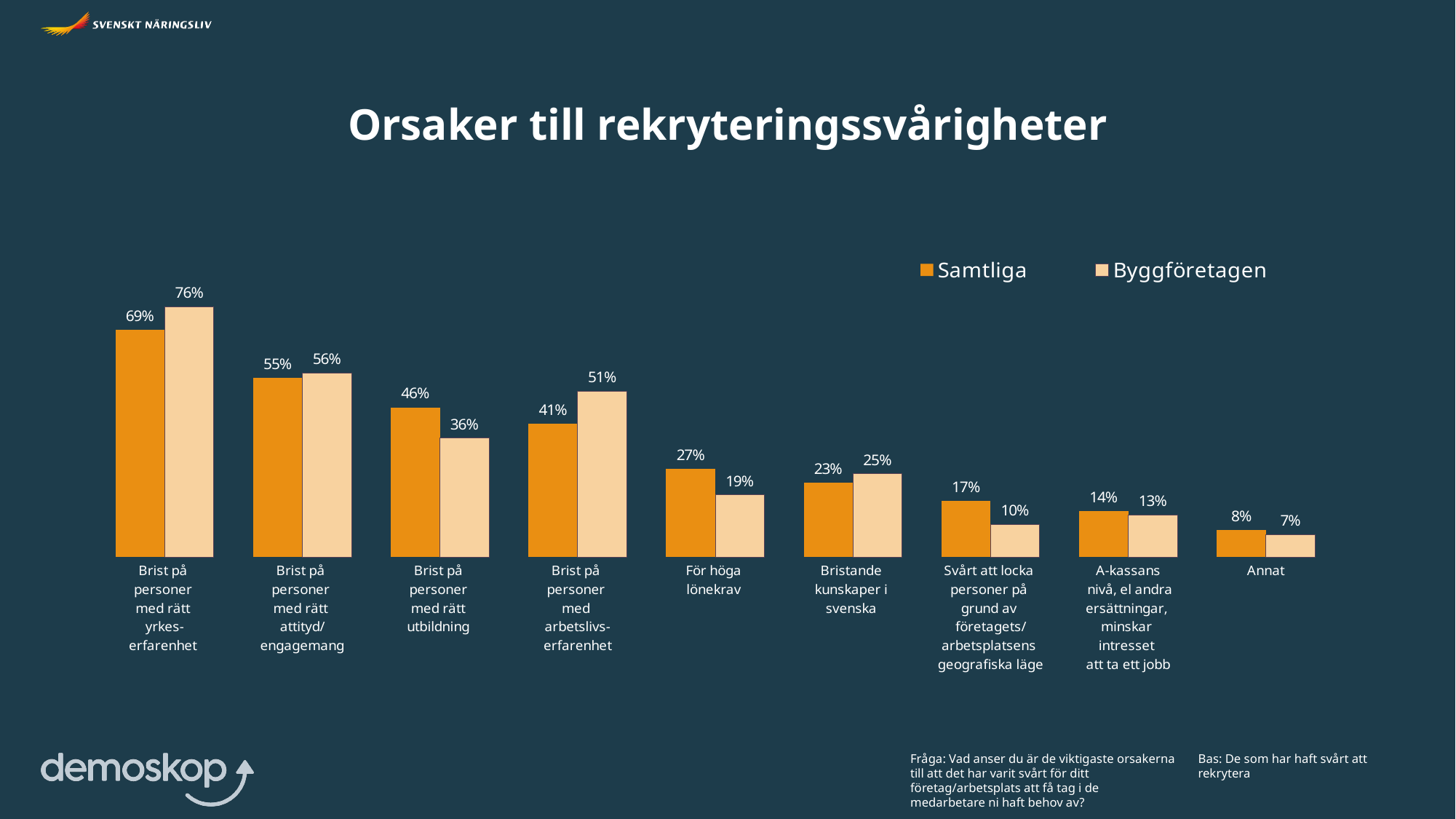
What is the title of the chart? Orsaker till rekryteringssvårigheter What is the difference between Byggföretagen and Samtliga for 'Brist på personer med arbetslivserfarenhet'? 10% Which category has the lowest value for Samtliga? Annat What is the value for Byggföretagen for 'För höga lönekrav'? 19% What is the value for Byggföretagen for 'Brist på personer med rätt utbildning'? 36% What is the value for Samtliga for 'Brist på personer med rätt yrkeserfarenhet'? 69% Which is larger for 'Bristande kunskaper i svenska': Samtliga or Byggföretagen? Byggföretagen How many categories are shown on the x axis? 9 Which category has the highest value for Byggföretagen? Brist på personer med rätt yrkeserfarenhet How many series does the legend list? 2 Which is larger for 'Svårt att locka personer på grund av företagets/arbetsplatsens geografiska läge': Samtliga or Byggföretagen? Samtliga What kind of chart is shown on the slide? Bar chart